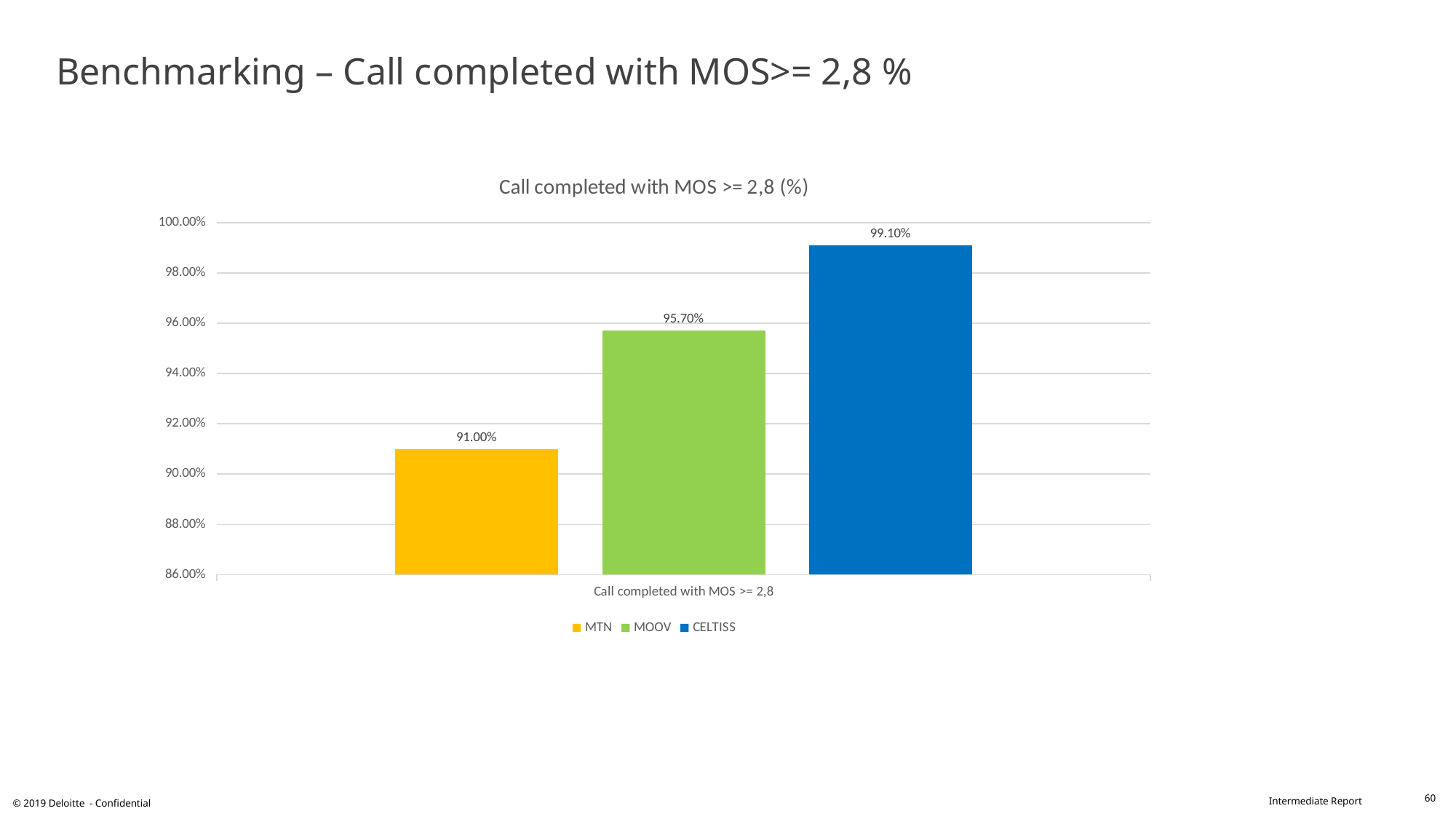
Which operator has the lowest value? MTN What kind of chart is shown on the slide? bar chart Is the value for MOOV greater or less than 94.00%? greater What is the difference between the values for CELTISS and MTN? 8.10% Which is larger, the value for MOOV or the value for MTN? MOOV Which operator has the highest value? CELTISS What is the difference between the values for MOOV and MTN? 4.70% What is the value for MOOV? 95.70% What is the value for CELTISS? 99.10% What is the value for MTN? 91.00% What is the title of the chart? Call completed with MOS >= 2,8 (%) How many series does the legend list? 3